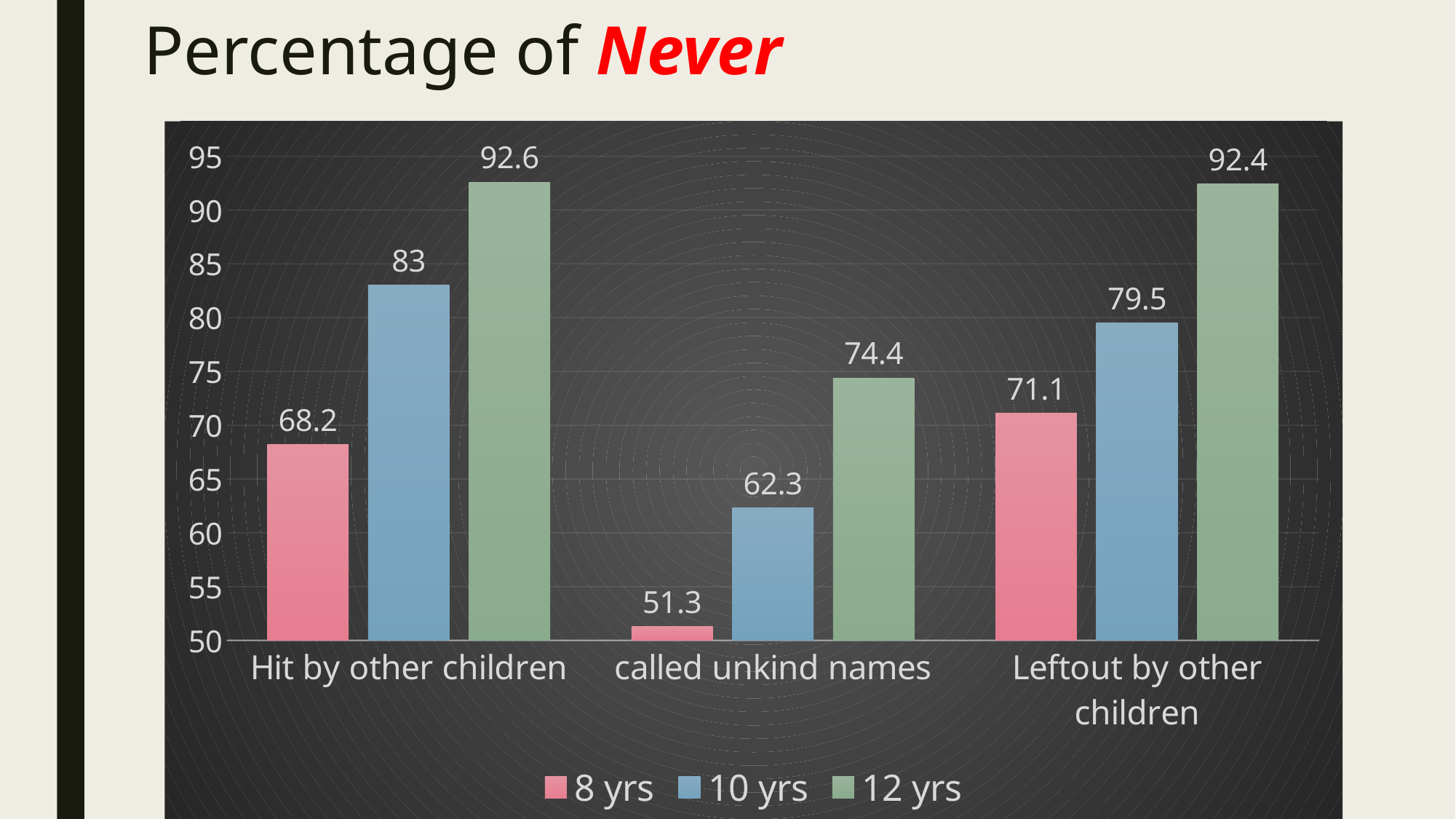
Is the value for 10 yrs in 'called unkind names' greater or less than 65? less What is the value for 10 yrs in the 'Leftout by other children' category? 79.5 What is the difference between the 12 yrs and 8 yrs values in the 'called unkind names' category? 23.1 Which is larger: the 8 yrs value for 'Hit by other children' or the 8 yrs value for 'Leftout by other children'? Leftout by other children Which category has the lowest value for the 12 yrs series? called unkind names How many series does the legend list? 3 Which category has the highest value for the 10 yrs series? Hit by other children What is the value for 8 yrs in the 'called unkind names' category? 51.3 What is the title of the slide? Percentage of Never What kind of chart is shown on the slide? bar chart What is the value for 12 yrs in the 'Hit by other children' category? 92.6 How many categories are shown on the x axis? 3